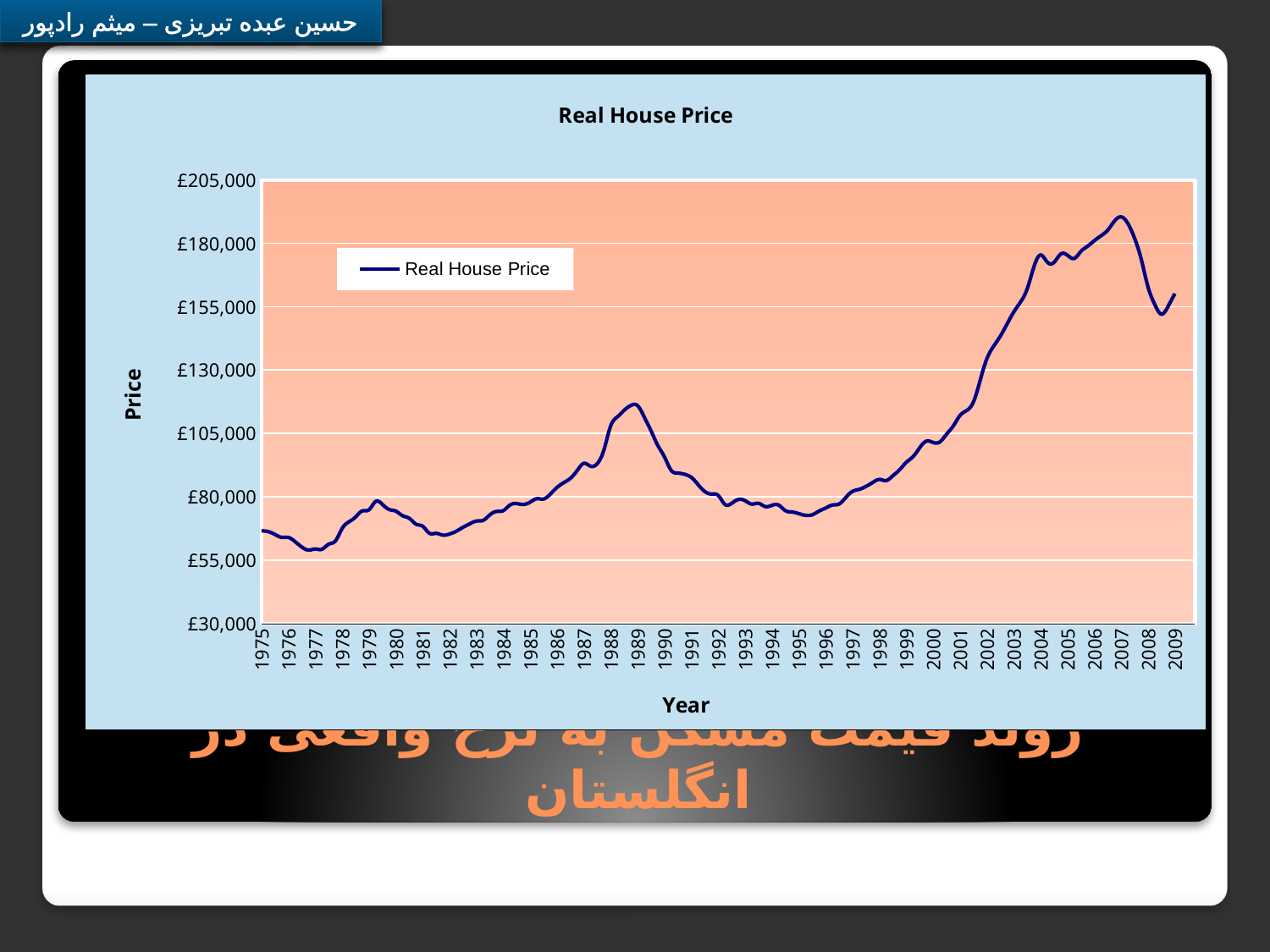
Which year has the higher Real House Price, 1989 or 2004? 2004 Is the Real House Price in 1989 greater or less than £105,000? greater Is the Real House Price in 1995 greater or less than £80,000? less Is the Real House Price in 2007 greater or less than £180,000? greater In which year does the Real House Price reach its highest point? 2007 What is the label of the x axis? Year How many series does the legend list? 1 Does the Real House Price rise or fall between 1989 and 1995? fall In which year is the Real House Price at its lowest? 1976 What is the title of the chart? Real House Price What kind of chart is shown on the slide? line chart